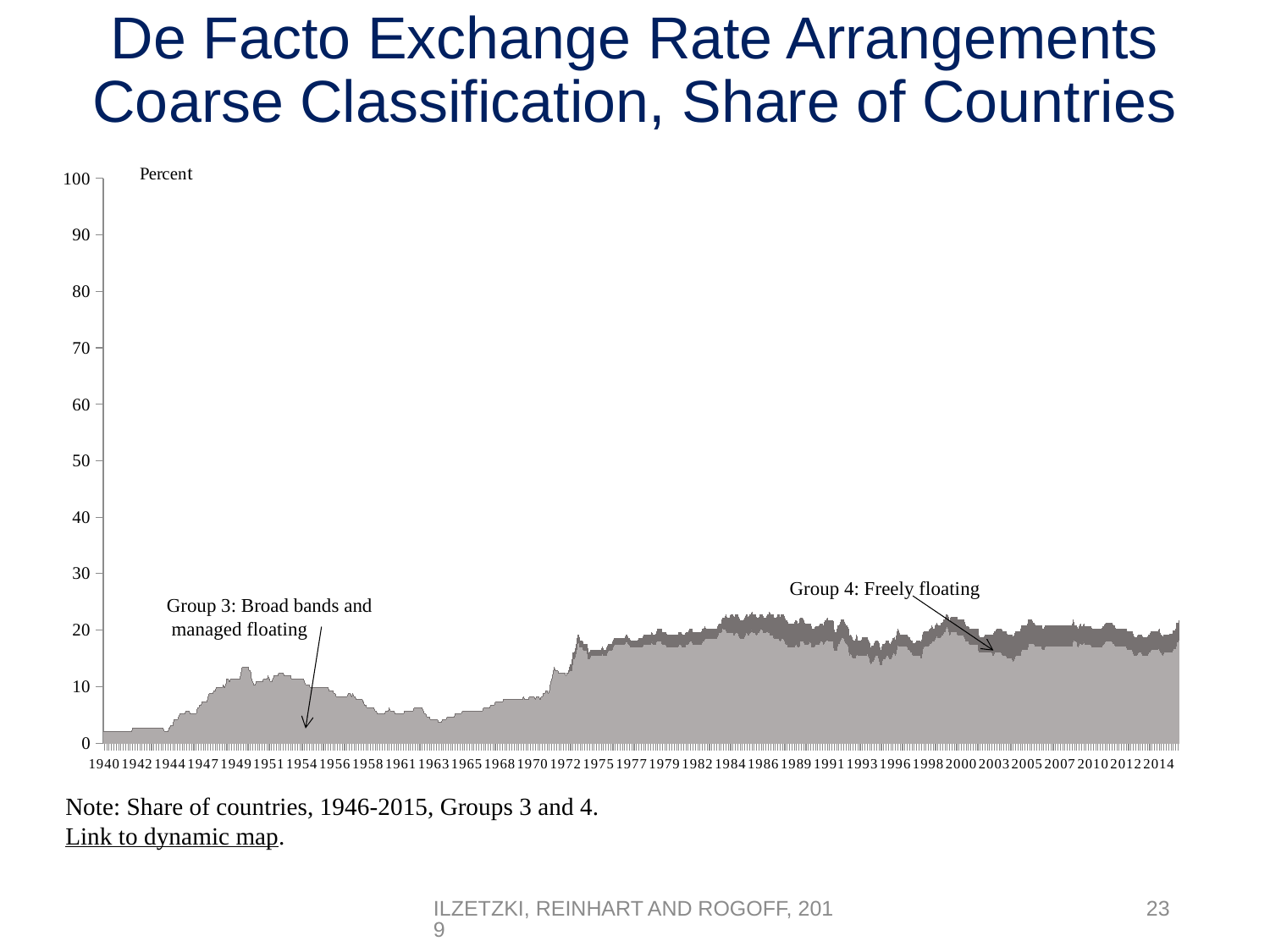
Is the value for Group 3: Broad bands and managed floating in 1940 greater or less than 10? less Is the combined share of Groups 3 and 4 in 1963 greater or less than 10? less Which series is plotted on top of the stack, in the darker shade? Group 4: Freely floating What kind of chart is shown on the slide? Stacked area chart Does the share for Group 3: Broad bands and managed floating rise or fall between 1963 and 1972? rise Does the share for Group 3: Broad bands and managed floating rise or fall between 1951 and 1963? fall What is the label on the y axis of the chart? Percent What is the highest value shown on the y axis? 100 How many series are plotted in the chart? 2 Is the combined share of Groups 3 and 4 in 2014 greater or less than 30? less Which is larger in 1984: the share for Group 3: Broad bands and managed floating or the share for Group 4: Freely floating? Group 3: Broad bands and managed floating